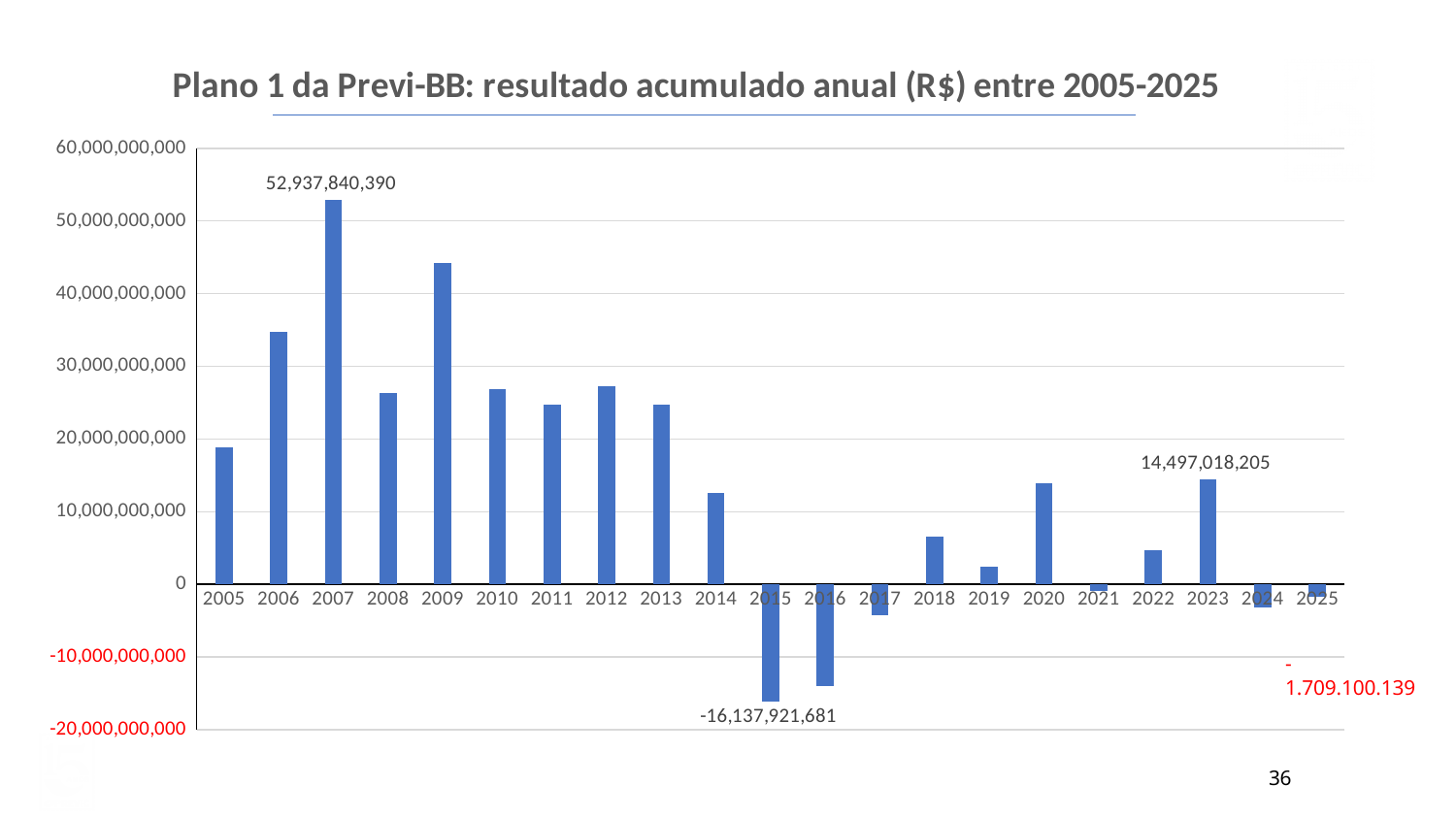
Which is larger, the value for 2007 or the value for 2009? 2007 What is the value for 2015? -16,137,921,681 What kind of chart is shown on the slide? bar chart Is the value for 2016 greater or less than -10,000,000,000? less What is the value for 2023? 14,497,018,205 Is the value for 2006 greater or less than 30,000,000,000? greater Which year has the lowest value? 2015 What is the difference between the values for 2007 and 2023? 38,440,822,185 Which year has the highest value? 2007 What is the value for 2007? 52,937,840,390 What is the title of the chart? Plano 1 da Previ-BB: resultado acumulado anual (R$) entre 2005-2025 How many years are shown on the x axis? 21